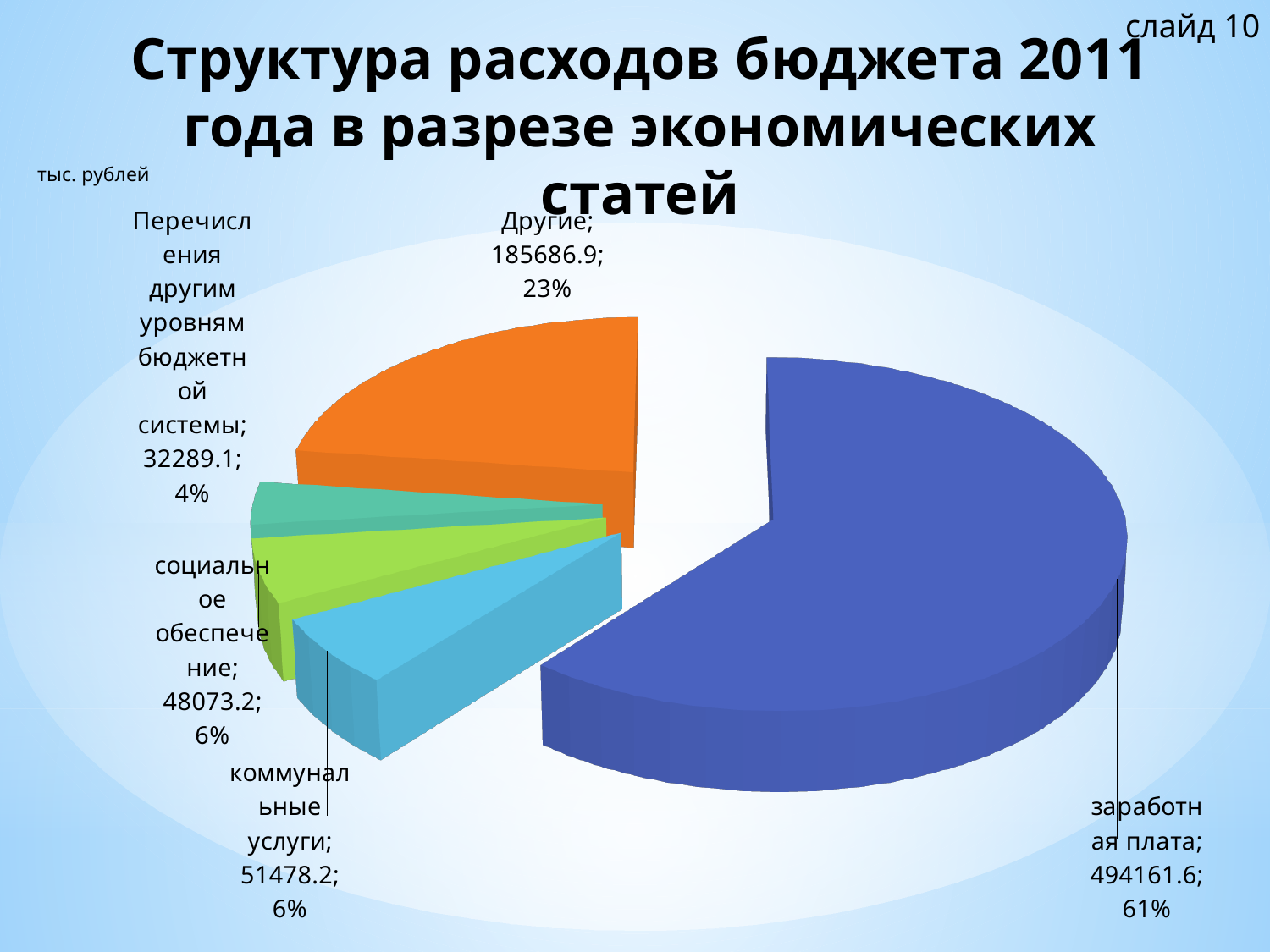
What type of chart is shown on the slide? pie chart Which is larger, the value for коммунальные услуги or the value for социальное обеспечение? коммунальные услуги What is the value for Перечисления другим уровням бюджетной системы? 32289.1 Which category has the largest value? заработная плата What is the difference between the values for заработная плата and Другие? 308474.7 What share of the pie does социальное обеспечение represent? 6% What is the value for заработная плата? 494161.6 Which category has the smallest value? Перечисления другим уровням бюджетной системы What is the value for коммунальные услуги? 51478.2 How many categories are shown in the pie chart? 5 What is the difference between the values for коммунальные услуги and социальное обеспечение? 3405 What share of the pie does Другие represent? 23%